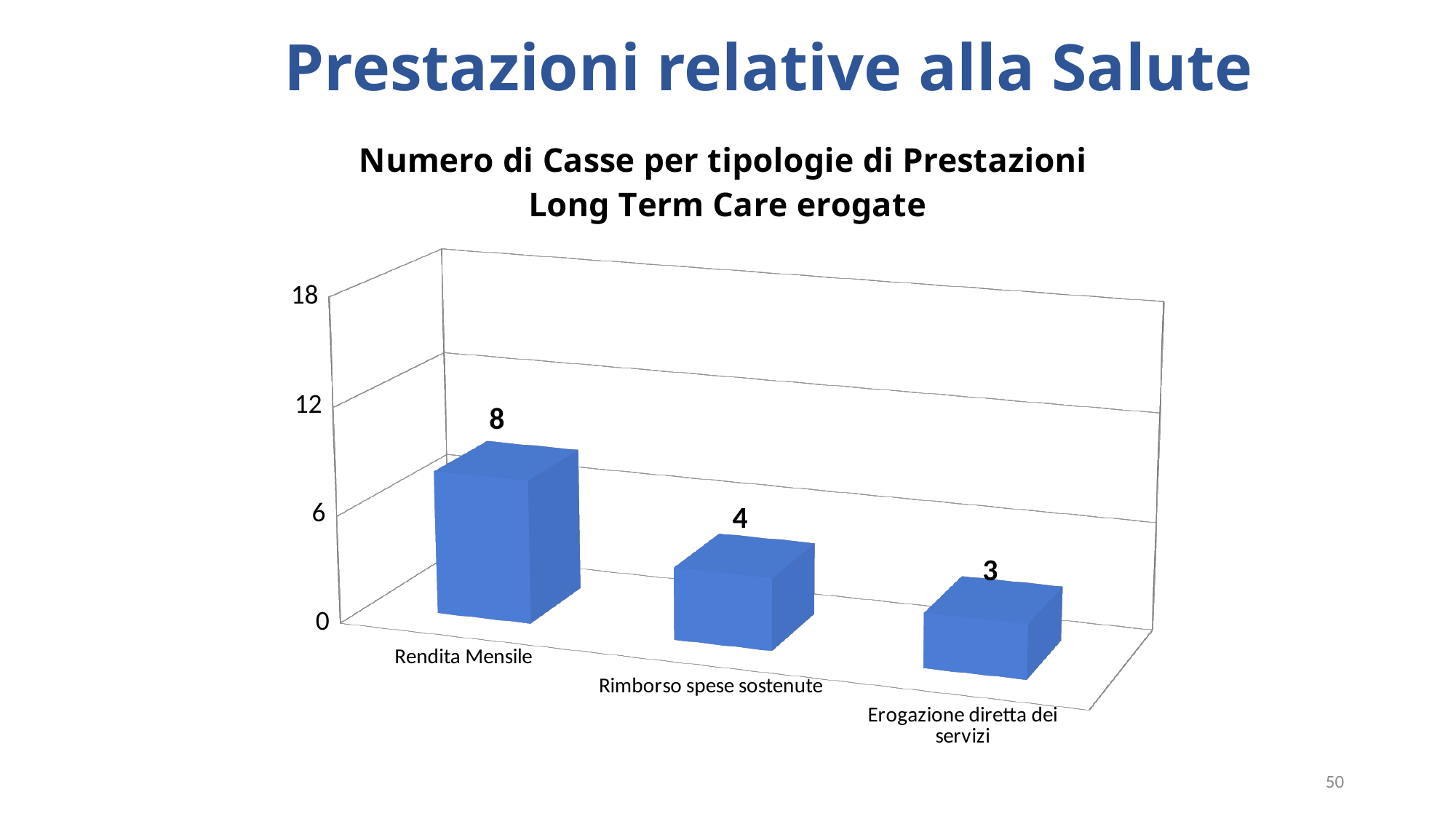
Which category has the lowest value? Erogazione diretta dei servizi How many categories are shown in the chart? 3 What is the title of the chart? Numero di Casse per tipologie di Prestazioni Long Term Care erogate Which is larger, the value for Rendita Mensile or the value for Erogazione diretta dei servizi? Rendita Mensile What is the value for Rendita Mensile? 8 Is the value for Rendita Mensile greater or less than 6? greater What is the value for Rimborso spese sostenute? 4 Which category has the highest value? Rendita Mensile What is the difference between the values for Rimborso spese sostenute and Erogazione diretta dei servizi? 1 What is the difference between the values for Rendita Mensile and Rimborso spese sostenute? 4 What is the value for Erogazione diretta dei servizi? 3 What kind of chart is shown on the slide? bar chart